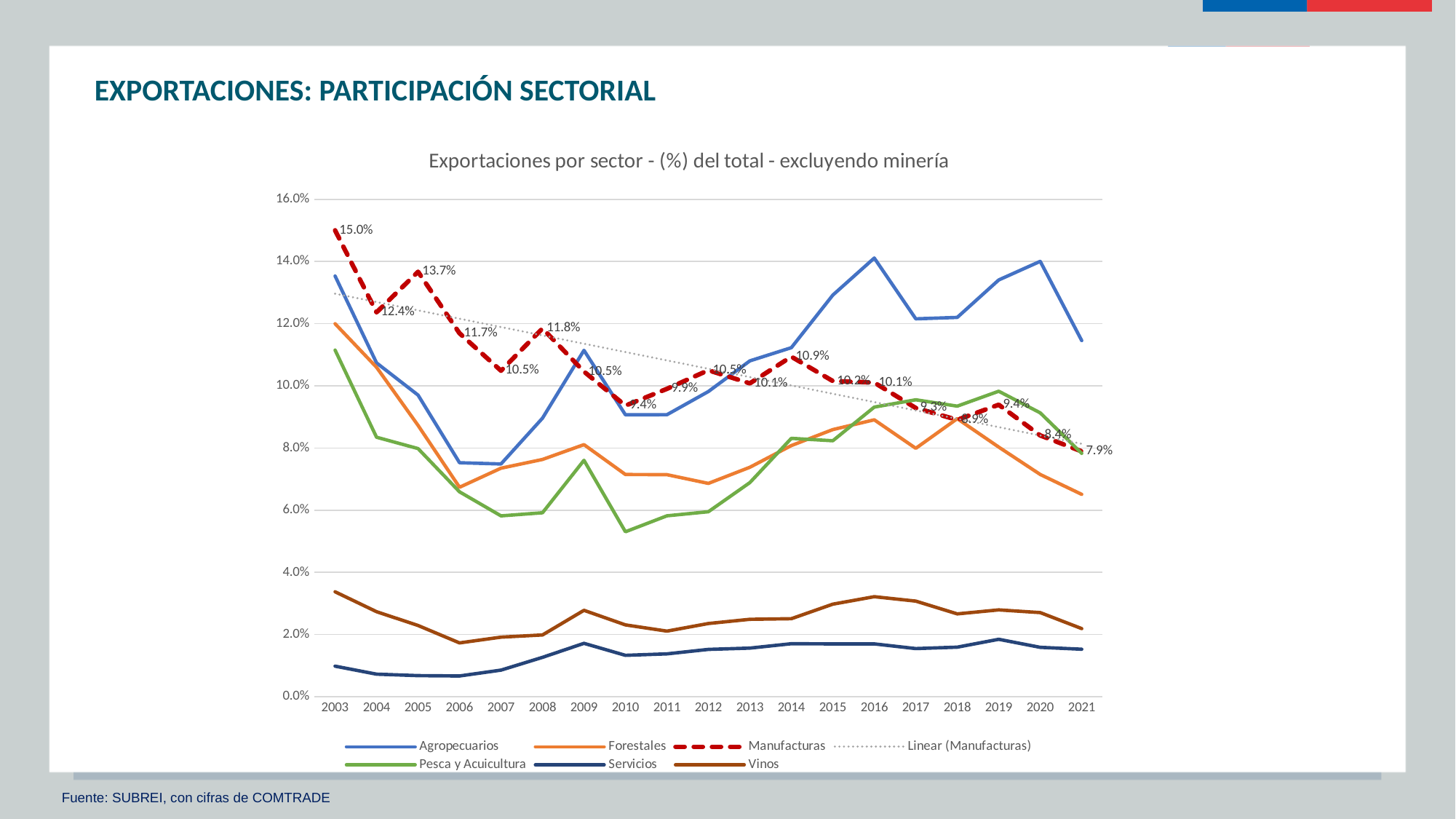
In which year is the Manufacturas value lowest? 2021 What is the value for Manufacturas in 2003? 15.0% What type of chart is shown on the slide? Line chart What is the value for Manufacturas in 2014? 10.9% In which year is the Manufacturas value highest? 2003 Does the Manufacturas series generally rise or fall from 2003 to 2021? Fall How many years are shown on the x axis? 19 Is the value for Servicios in 2021 greater or less than 2.0%? less What is the value for Manufacturas in 2021? 7.9% What is the difference between the Manufacturas value in 2003 and in 2021? 7.1 percentage points What is the title of the chart? Exportaciones por sector - (%) del total - excluyendo minería How many series does the legend list? 7